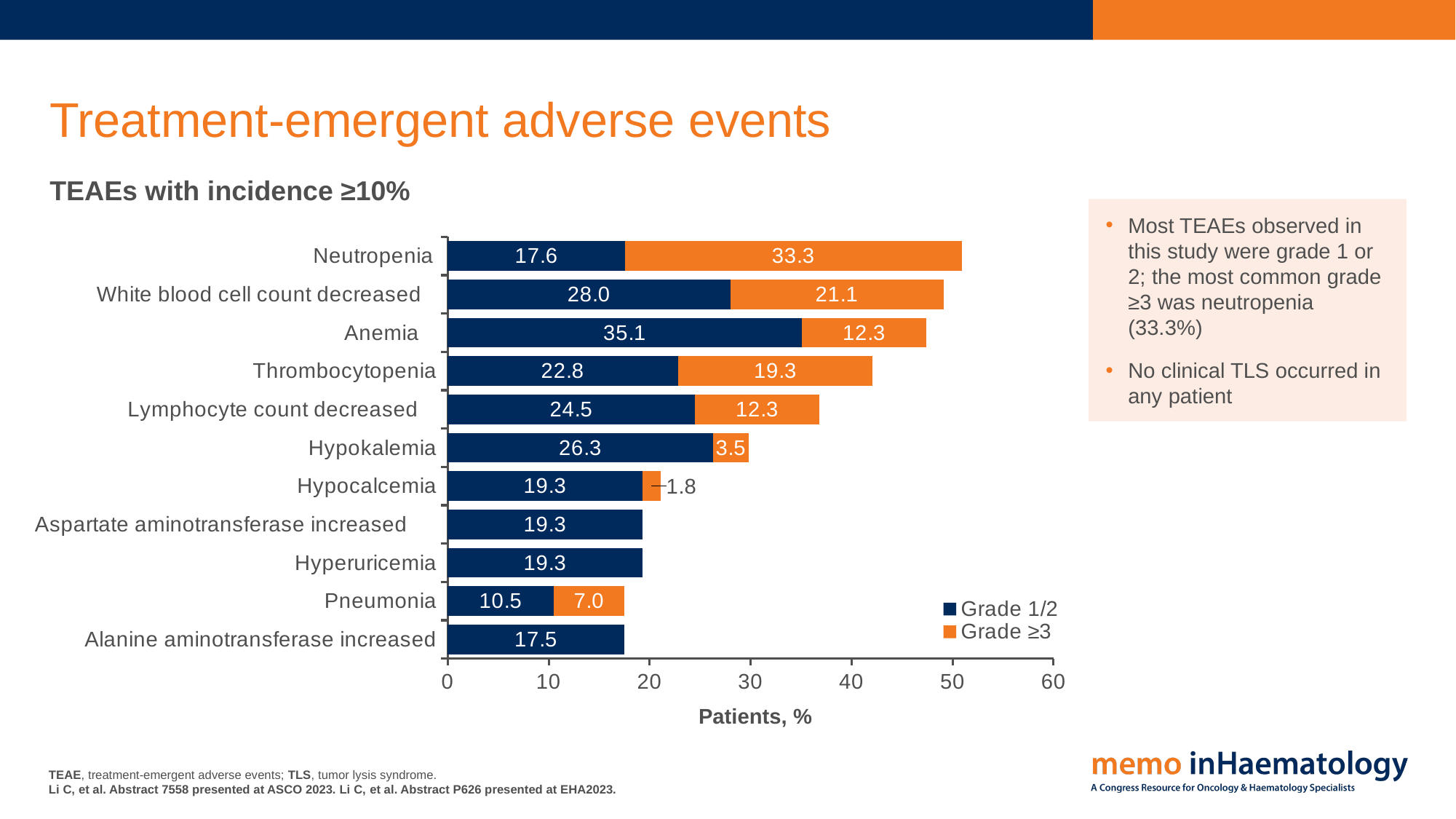
What is the Grade 1/2 value for Anemia? 35.1 Which category has the highest Grade ≥3 value? Neutropenia Which is larger for Thrombocytopenia, the Grade 1/2 value or the Grade ≥3 value? Grade 1/2 How many series does the legend list? 2 What is the total stacked value for Neutropenia (Grade 1/2 plus Grade ≥3)? 50.9 What is the Grade ≥3 value for Neutropenia? 33.3 What is the title of the x axis? Patients, % Which category has the highest Grade 1/2 value? Anemia What kind of chart is shown on the slide? Stacked bar chart What is the difference between the Grade ≥3 and Grade 1/2 values for Neutropenia? 15.7 How many adverse event categories are shown in the chart? 11 What is the Grade ≥3 value for Pneumonia? 7.0